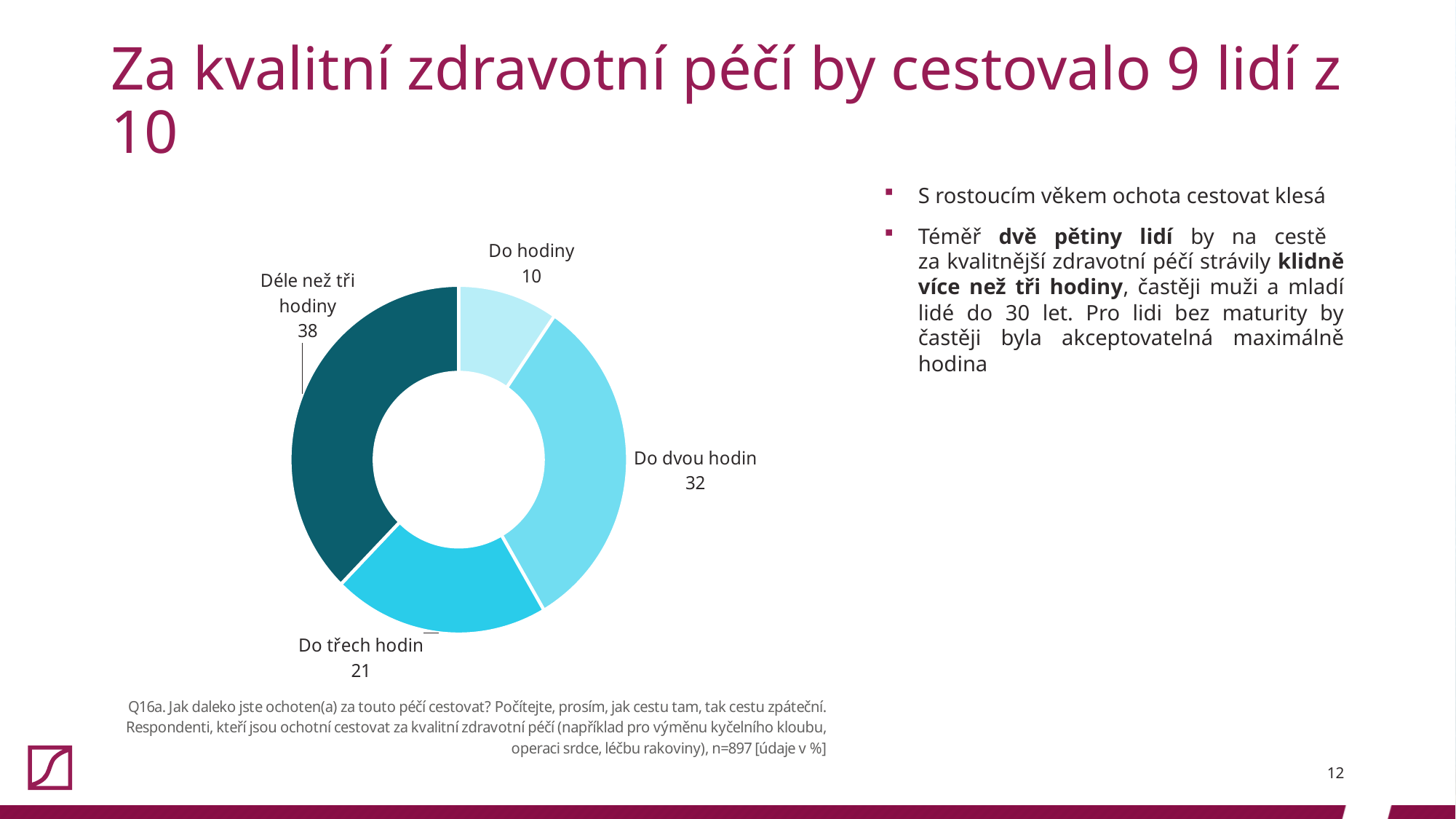
Which category is shown in the darkest colour? Déle než tři hodiny Which category has the lowest value? Do hodiny What is the difference between the values for "Do dvou hodin" and "Do hodiny"? 22 How many categories does the chart show? 4 What is the value for "Do třech hodin"? 21 What is the difference between the values for "Déle než tři hodiny" and "Do dvou hodin"? 6 Which category has the highest value? Déle než tři hodiny What is the value for "Do dvou hodin"? 32 What is the value for "Do hodiny"? 10 What kind of chart is shown on the slide? Pie chart (donut) What is the value for "Déle než tři hodiny"? 38 Which is larger, the value for "Do třech hodin" or the value for "Do dvou hodin"? Do dvou hodin